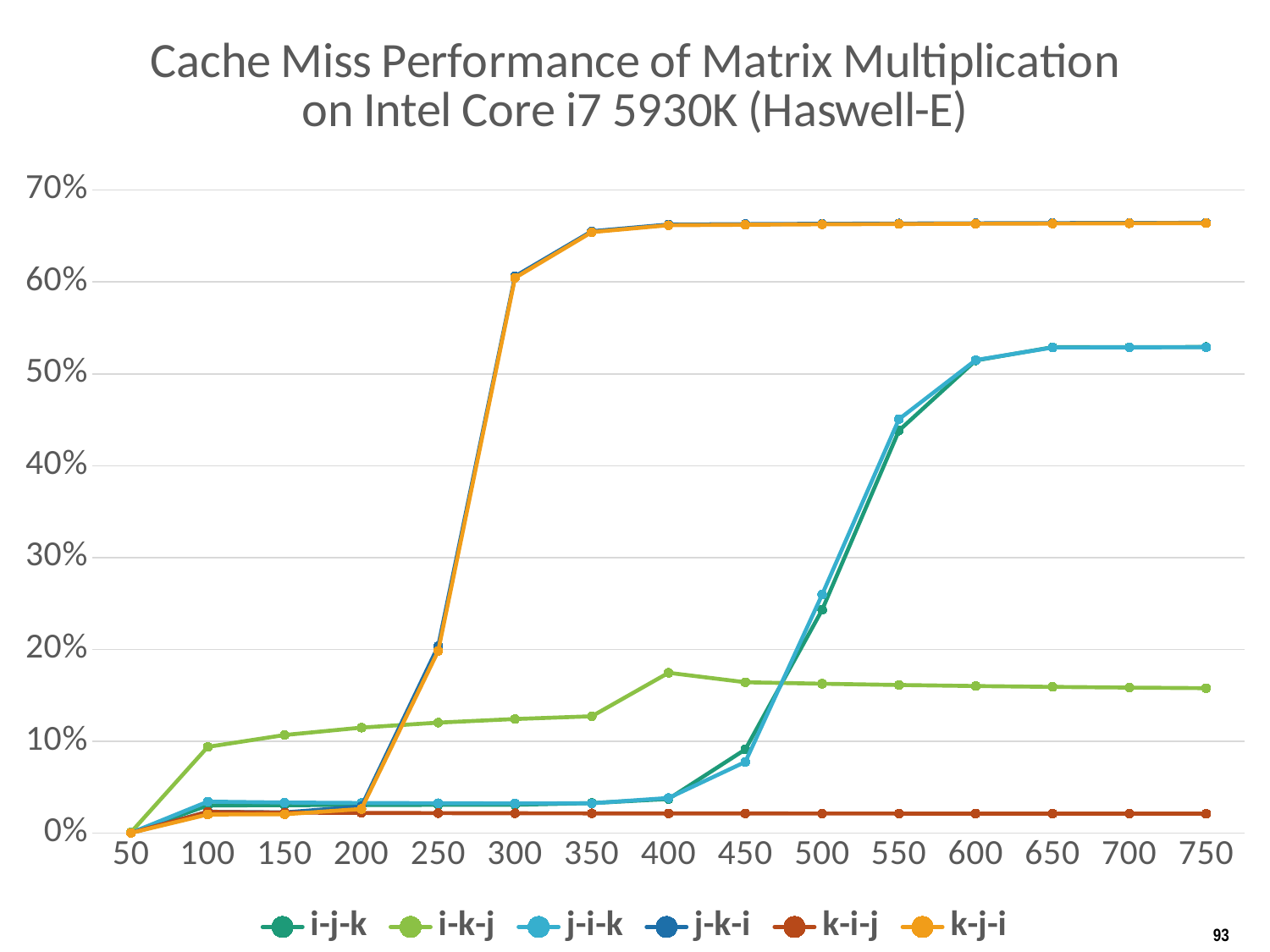
At 250, which series has a larger value, i-k-j or j-i-k? i-k-j Which series has the lowest value at 750? k-i-j Is the value for j-i-k at 400 greater or less than 10%? less What is the title of the chart? Cache Miss Performance of Matrix Multiplication on Intel Core i7 5930K (Haswell-E) How many x-axis categories (matrix sizes) are plotted? 15 Is the value for i-k-j at 400 greater or less than 10%? greater At 750, which series has a higher value, k-j-i or j-i-k? k-j-i Is the value for k-j-i at 300 greater or less than 50%? greater What kind of chart is shown on the slide? line chart Does the j-i-k series rise or fall between 450 and 600? rise How many series does the legend list? 6